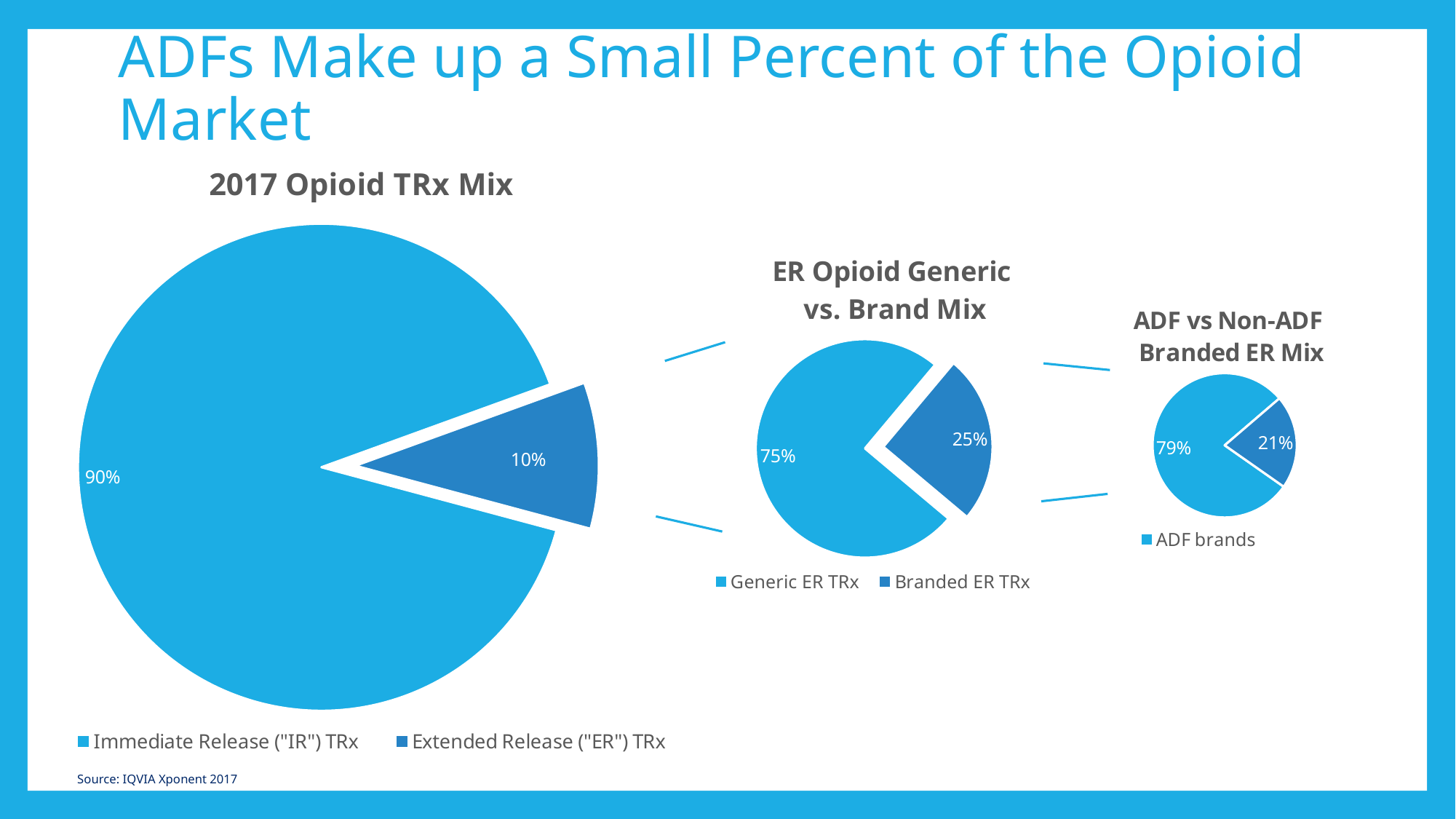
In the "2017 Opioid TRx Mix" chart, what share is Extended Release ("ER") TRx? 10% In the "ADF vs Non-ADF Branded ER Mix" chart, what is the value of the smaller slice? 21% In the "ADF vs Non-ADF Branded ER Mix" chart, what share is ADF brands? 79% In the "ER Opioid Generic vs. Brand Mix" chart, which category is the smallest? Branded ER TRx What kind of chart is the "2017 Opioid TRx Mix" chart? Pie chart In the "2017 Opioid TRx Mix" chart, what share is Immediate Release ("IR") TRx? 90% How many entries does the legend of the "ER Opioid Generic vs. Brand Mix" chart list? 2 In the "ER Opioid Generic vs. Brand Mix" chart, how many slices does the pie have? 2 In the "2017 Opioid TRx Mix" chart, what is the difference between the IR and ER shares? 80 percentage points In the "2017 Opioid TRx Mix" chart, which category is the largest? Immediate Release ("IR") TRx